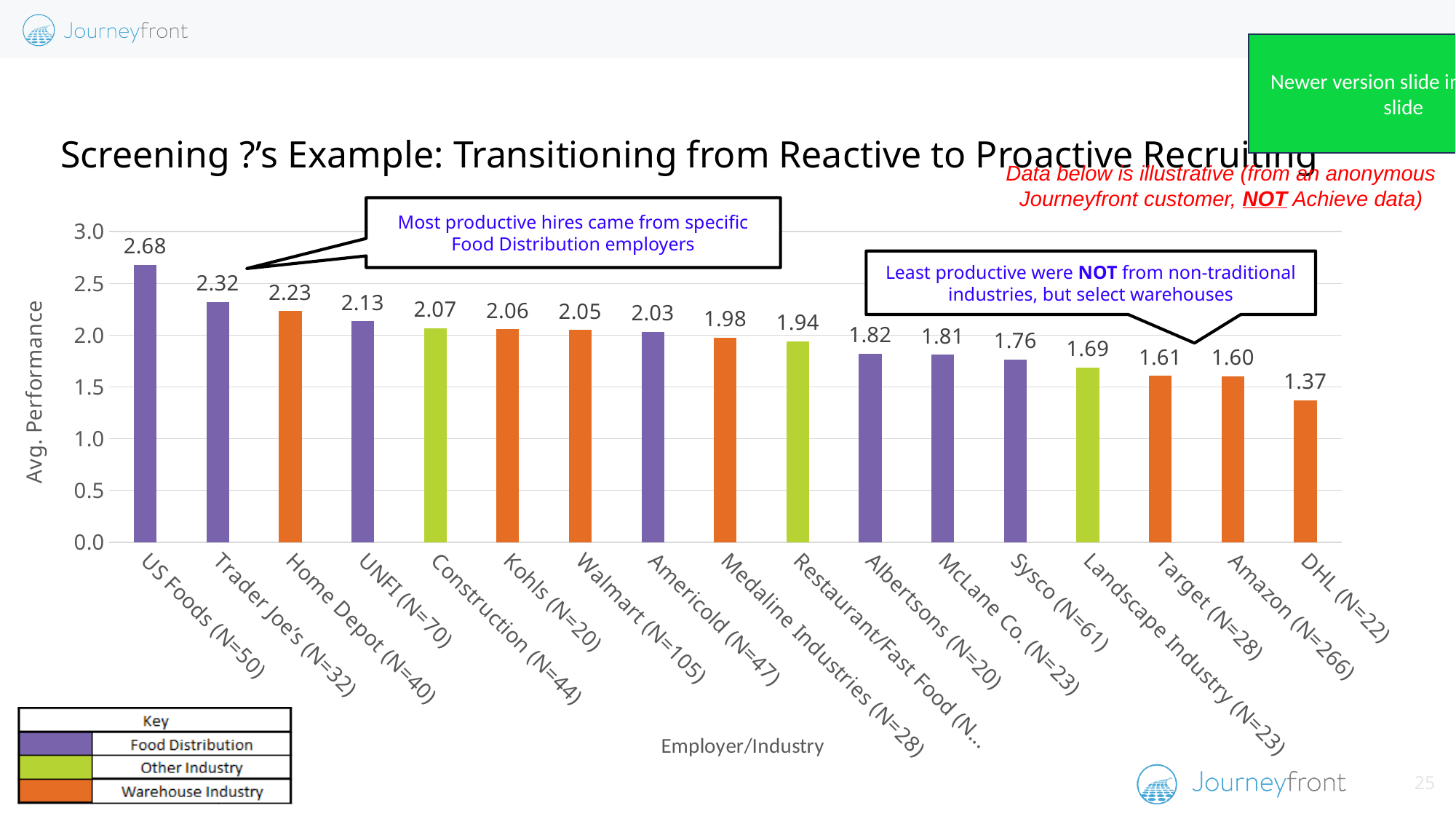
What is the difference in average performance between US Foods and DHL? 1.31 What type of chart is shown on the slide? Bar chart What is the average performance value for Amazon? 1.60 What is the average performance value for US Foods? 2.68 What is the difference in average performance between Home Depot and Target? 0.62 According to the key, which industry group do the orange bars represent? Warehouse Industry Which has a higher average performance, Trader Joe's or Landscape Industry? Trader Joe's Which employer/industry has the highest average performance? US Foods Which employer/industry has the lowest average performance? DHL Do the average performance values rise or fall moving from left to right along the x axis? Fall What is the average performance value for Sysco? 1.76 How many employer/industry categories are shown in the chart? 17